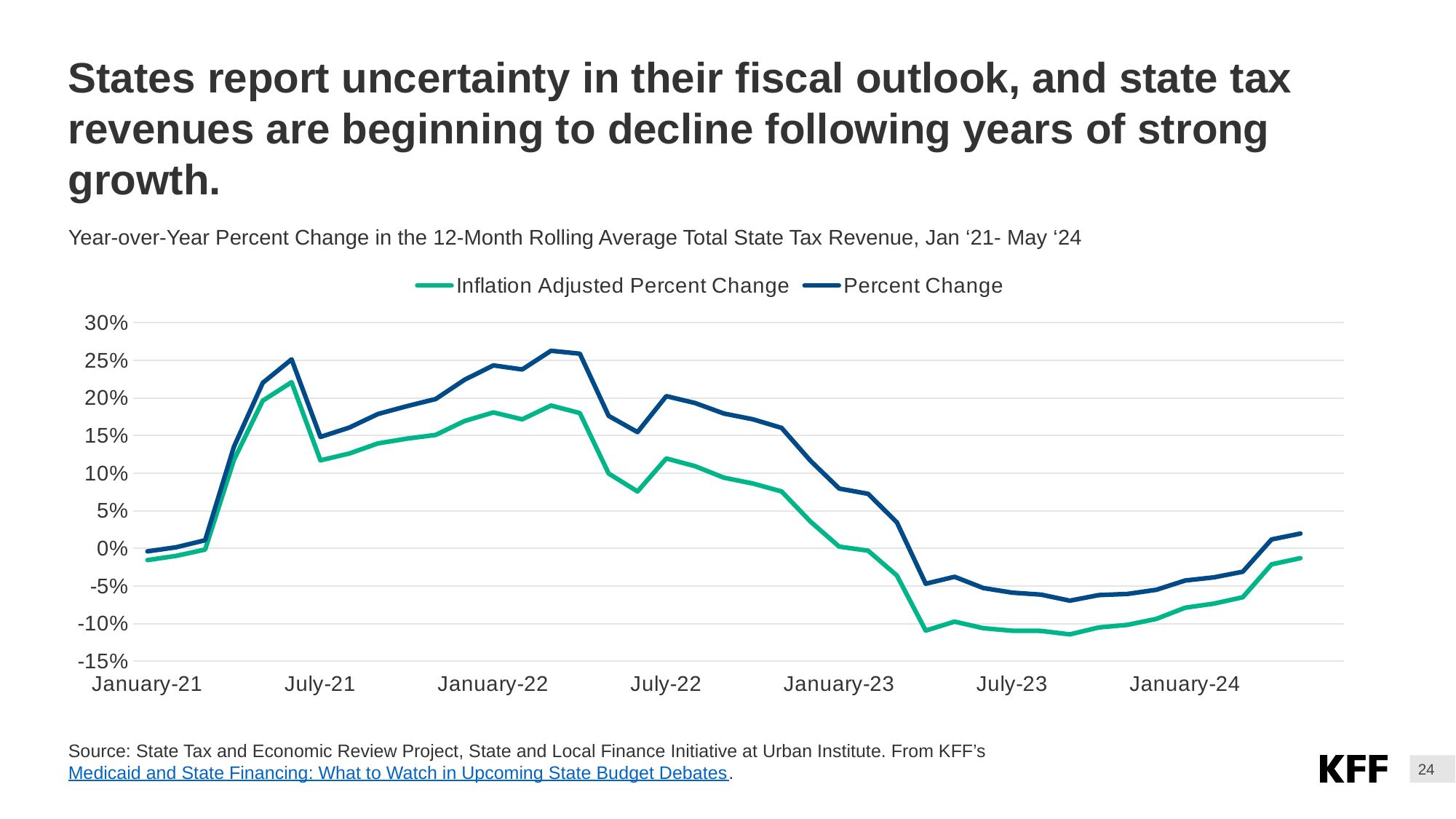
How many series does the legend list? 2 Is the value of Percent Change at January-21 greater or less than 5%? less At January-22, which series has the higher value, Inflation Adjusted Percent Change or Percent Change? Percent Change Between January-23 and July-23, does the Percent Change line rise or fall? fall Is the Percent Change value higher at January-22 or at January-23? January-22 Is the value of Percent Change at July-21 greater or less than 10%? greater Which series reaches the highest peak on the chart? Percent Change Which colour is used for the Inflation Adjusted Percent Change line? green What kind of chart is shown on the slide? line chart Is the value of Inflation Adjusted Percent Change at January-23 greater or less than 5%? less What are the two series named in the legend? Inflation Adjusted Percent Change and Percent Change